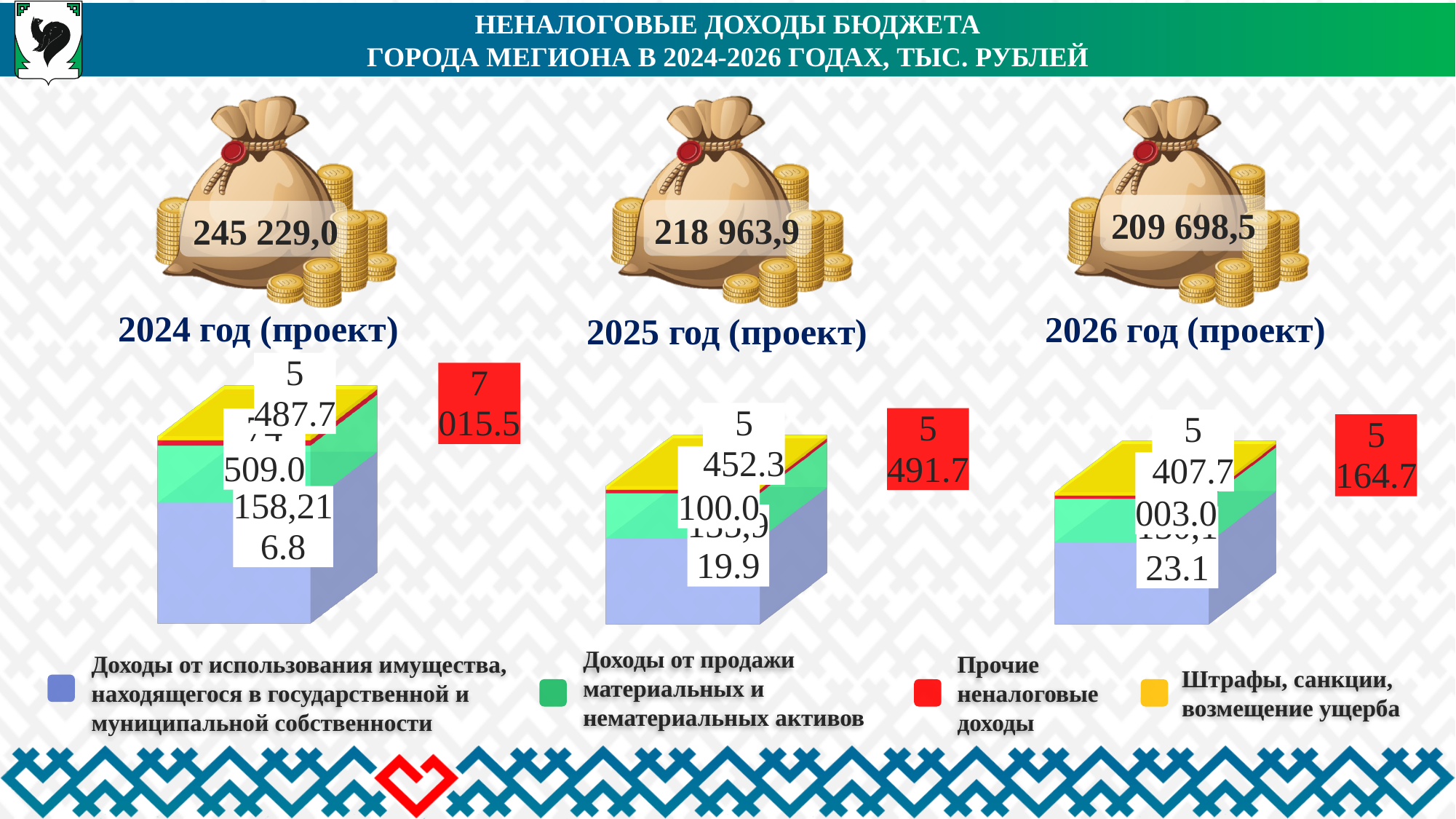
Do the total non-tax revenues rise or fall from 2024 to 2026? fall In the 2026 chart, what is the value for Штрафы, санкции, возмещение ущерба? 5 407.7 How many years (bars) are shown on the slide? 3 What is the total non-tax revenue shown for 2026 год (проект)? 209 698,5 What kind of chart is used to show the breakdown of non-tax revenues for each year? stacked bar chart Which is larger: Прочие неналоговые доходы in 2024 or in 2025? 2024 What is the total non-tax revenue shown for 2024 год (проект)? 245 229,0 In the 2024 chart, what is the value for Прочие неналоговые доходы? 7 015.5 How many series does the legend list? 4 What colour in the legend represents Штрафы, санкции, возмещение ущерба? yellow Which year has the highest total non-tax revenue? 2024 год (проект) Which year has the lowest total non-tax revenue? 2026 год (проект)